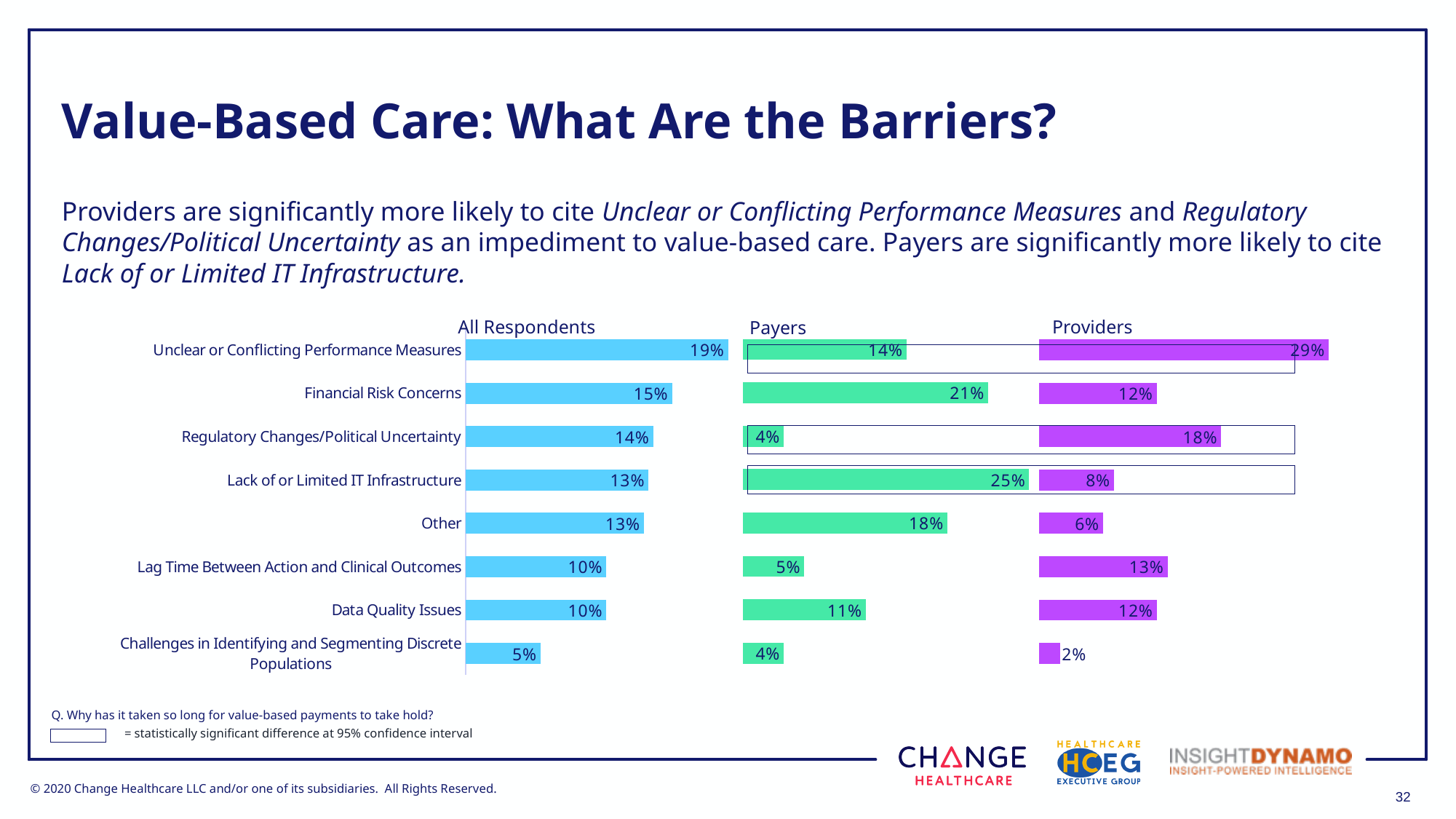
In the All Respondents chart, what percentage cited Unclear or Conflicting Performance Measures? 19% In the Providers chart, what percentage cited Regulatory Changes/Political Uncertainty? 18% What is the difference between the Providers and Payers percentages for Unclear or Conflicting Performance Measures? 15% In the Payers chart, what percentage cited Lack of or Limited IT Infrastructure? 25% In the Providers chart, which barrier has the lowest percentage? Challenges in Identifying and Segmenting Discrete Populations What type of chart is used to show the Providers data? Bar chart In the All Respondents chart, which barrier has the highest percentage? Unclear or Conflicting Performance Measures In the Payers chart, which barrier has the highest percentage? Lack of or Limited IT Infrastructure In the Payers chart, what percentage cited Other? 18% What is the difference between the Payers and Providers percentages for Lack of or Limited IT Infrastructure? 17% How many barrier categories are listed in the All Respondents chart? 8 For Financial Risk Concerns, which is larger: the Payers value or the Providers value? Payers